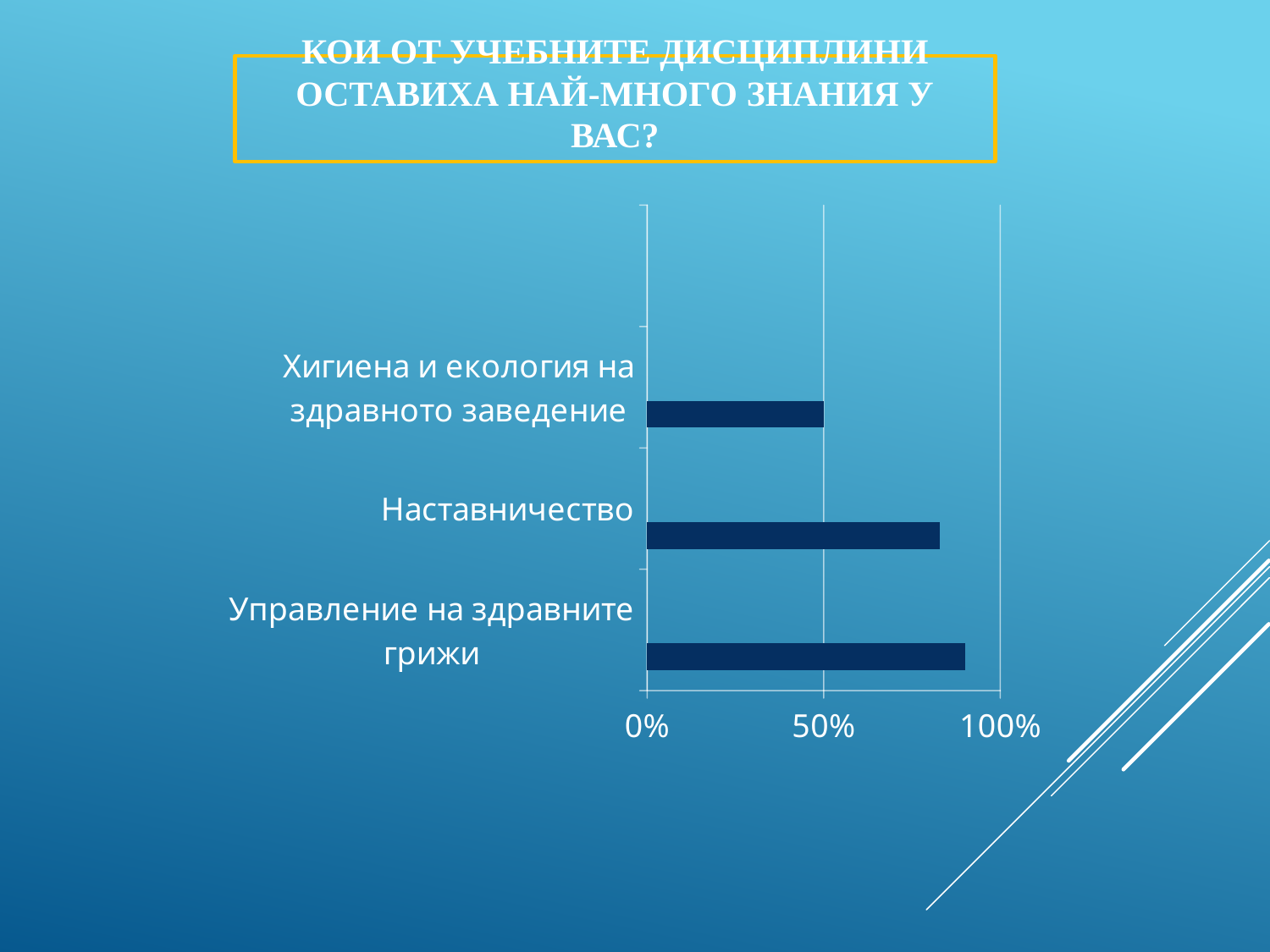
What is the value for Хигиена и екология на здравното заведение? 50% What kind of chart is shown on the slide? bar chart Which has a larger value: Управление на здравните грижи or Хигиена и екология на здравното заведение? Управление на здравните грижи Is the value for Наставничество greater or less than 100%? less Which discipline has the lowest value in the chart? Хигиена и екология на здравното заведение What is the highest value shown on the horizontal axis of the chart? 100% What is the title of the chart on the slide? КОИ ОТ УЧЕБНИТЕ ДИСЦИПЛИНИ ОСТАВИХА НАЙ-МНОГО ЗНАНИЯ У ВАС? Which discipline has the highest value in the chart? Управление на здравните грижи How many categories (disciplines) are shown in the chart? 3 Is the value for Управление на здравните грижи greater or less than 50%? greater Which has a larger value: Наставничество or Хигиена и екология на здравното заведение? Наставничество Is the value for Наставничество greater or less than 50%? greater